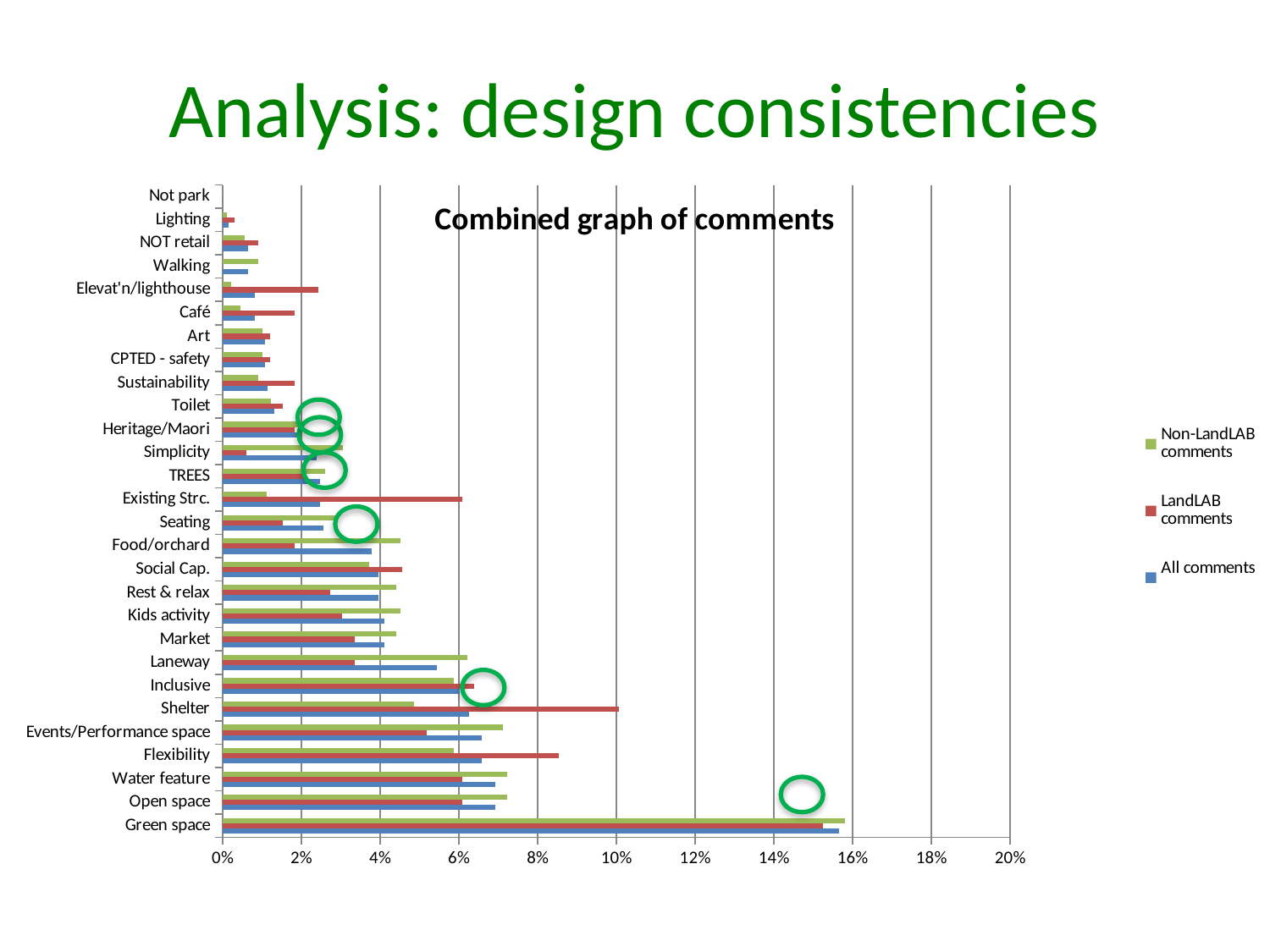
Which legend entry is shown in green? Non-LandLAB comments Is the All comments value for Lighting greater or less than 2%? less Is the All comments value for Green space greater or less than 14%? greater For Shelter, which is larger: the LandLAB comments value or the Non-LandLAB comments value? LandLAB comments How many series does the legend list? 3 How many categories are shown on the vertical axis of the chart? 28 What is the title of the chart? Combined graph of comments Which category has the highest value for All comments? Green space What kind of chart is shown on the slide? Bar chart For Elevat'n/lighthouse, which is larger: the LandLAB comments value or the All comments value? LandLAB comments Is the LandLAB comments value for Existing Strc. greater or less than 4%? greater